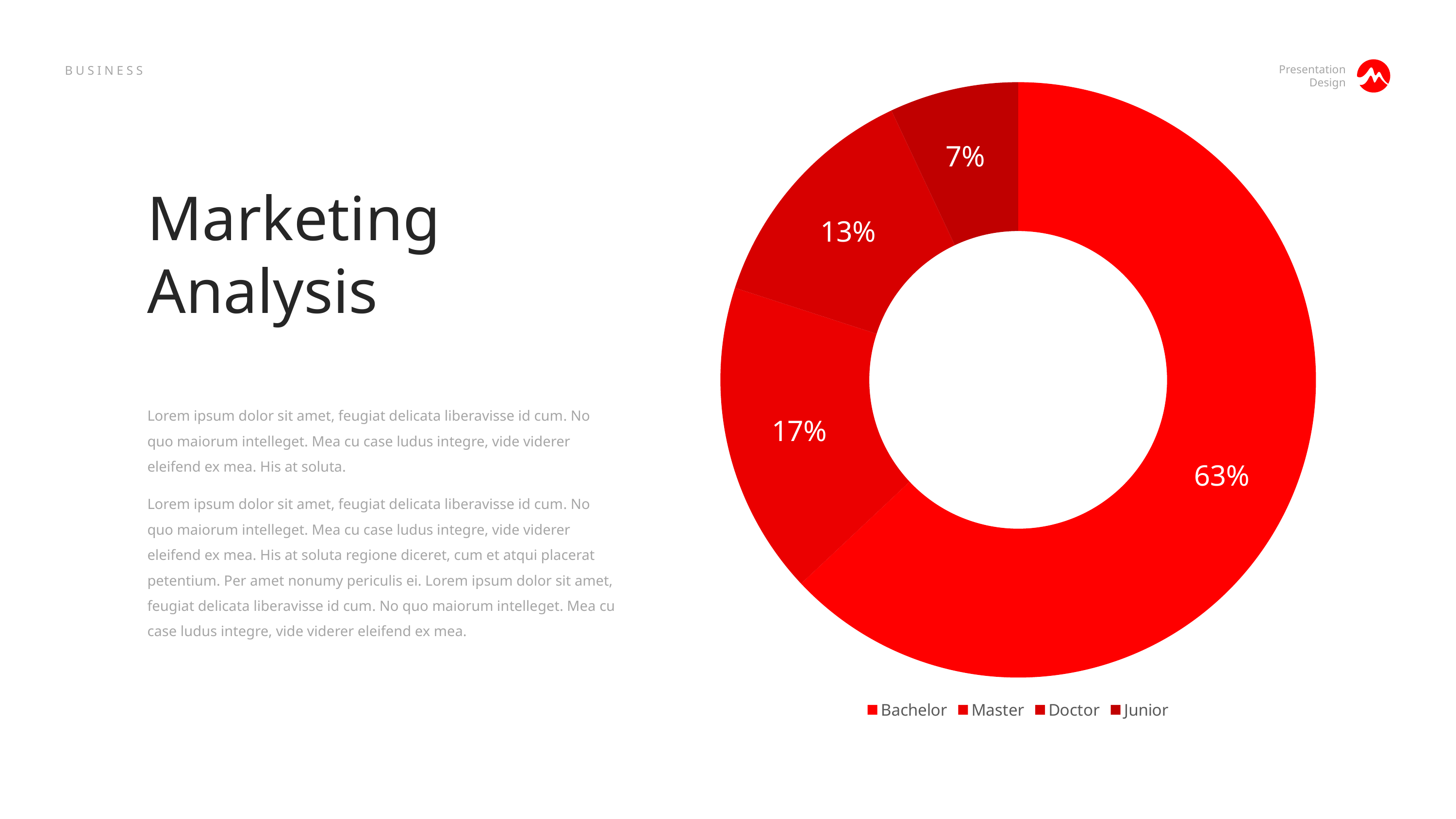
What is the combined share of Doctor and Junior? 20% How many categories does the chart show? 4 Which legend entry is listed first? Bachelor Which category has the smallest share of the chart? Junior What percentage is shown for Bachelor? 63% What percentage is shown for Doctor? 13% Which is larger, the share for Master or the share for Doctor? Master Which category has the largest share of the chart? Bachelor What percentage is shown for Master? 17% What kind of chart is shown on the slide? Doughnut chart What percentage is shown for Junior? 7% What is the difference in percentage points between Bachelor and Master? 46